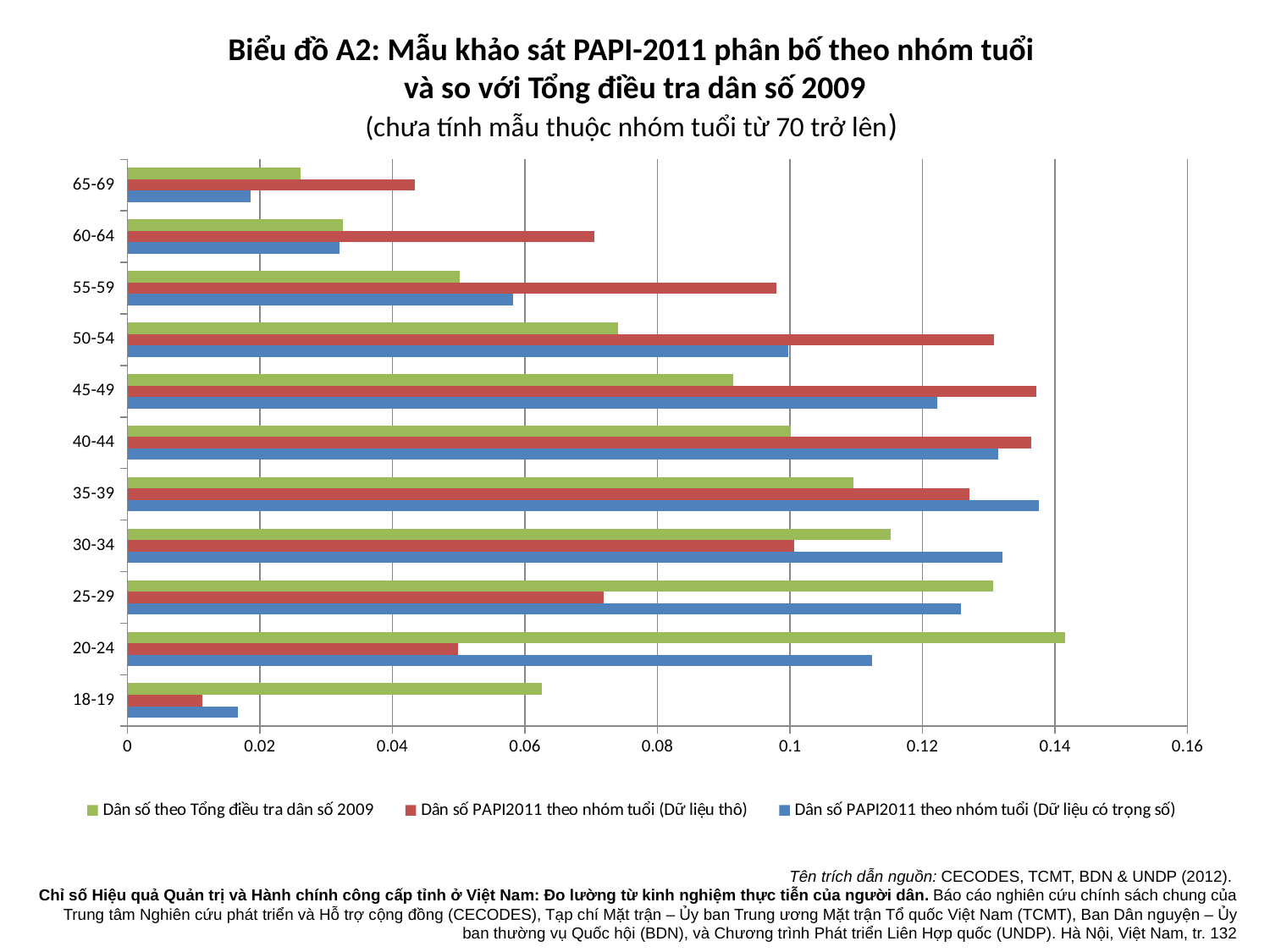
For the 18-19 age group, which series has the larger value: 'Dân số theo Tổng điều tra dân số 2009' or 'Dân số PAPI2011 theo nhóm tuổi (Dữ liệu thô)'? Dân số theo Tổng điều tra dân số 2009 Is the value for the 18-19 age group in the series 'Dân số PAPI2011 theo nhóm tuổi (Dữ liệu thô)' greater or less than 0.02? less What colour represents the series 'Dân số theo Tổng điều tra dân số 2009' in the legend? green Is the value for the 20-24 age group in the series 'Dân số theo Tổng điều tra dân số 2009' greater or less than 0.12? greater Is the value for the 50-54 age group in the series 'Dân số theo Tổng điều tra dân số 2009' greater or less than 0.08? less Which age group has the lowest value for the series 'Dân số PAPI2011 theo nhóm tuổi (Dữ liệu thô)'? 18-19 How many age groups are shown on the chart? 11 How many series does the legend list? 3 For the 20-24 age group, which series has the larger value: 'Dân số PAPI2011 theo nhóm tuổi (Dữ liệu có trọng số)' or 'Dân số PAPI2011 theo nhóm tuổi (Dữ liệu thô)'? Dân số PAPI2011 theo nhóm tuổi (Dữ liệu có trọng số) Which age group has the highest value for the series 'Dân số theo Tổng điều tra dân số 2009'? 20-24 What kind of chart is shown on the slide? bar chart